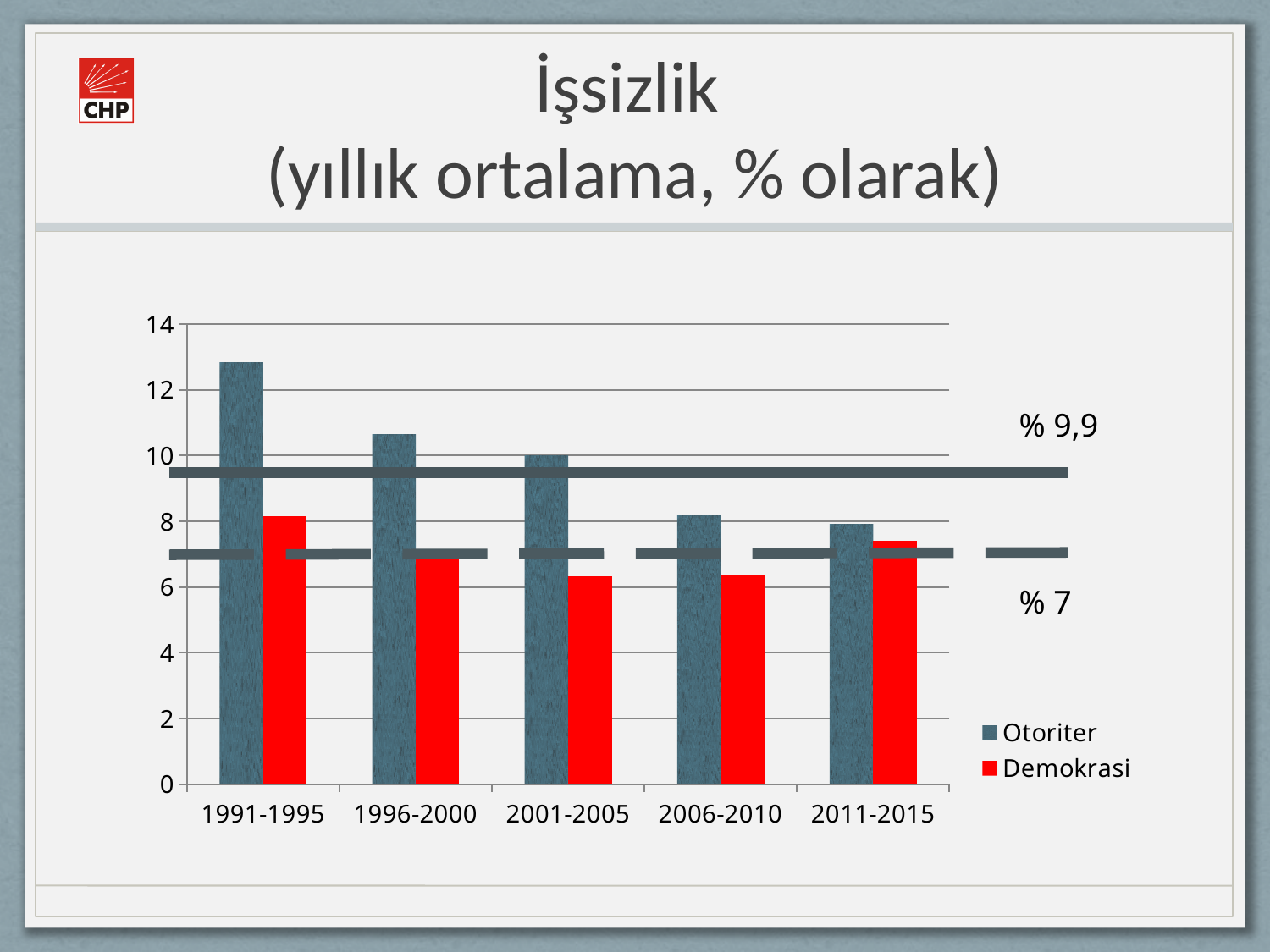
Is the Otoriter value for 1996-2000 greater or less than 10? greater Is the Otoriter value for 1991-1995 greater or less than 12? greater What is the title of the chart? İşsizlik (yıllık ortalama, % olarak) How many series does the legend list? 2 Do the Otoriter values rise or fall from 1991-1995 to 2011-2015? fall Which period has the highest Otoriter value? 1991-1995 In 1991-1995, which is larger: Otoriter or Demokrasi? Otoriter What kind of chart is shown on the slide? bar chart How many time periods are shown on the x axis? 5 Which period has the highest Demokrasi value? 1991-1995 What value is labelled on the upper horizontal reference line? % 9,9 Is the Demokrasi value for 2001-2005 greater or less than 7? less